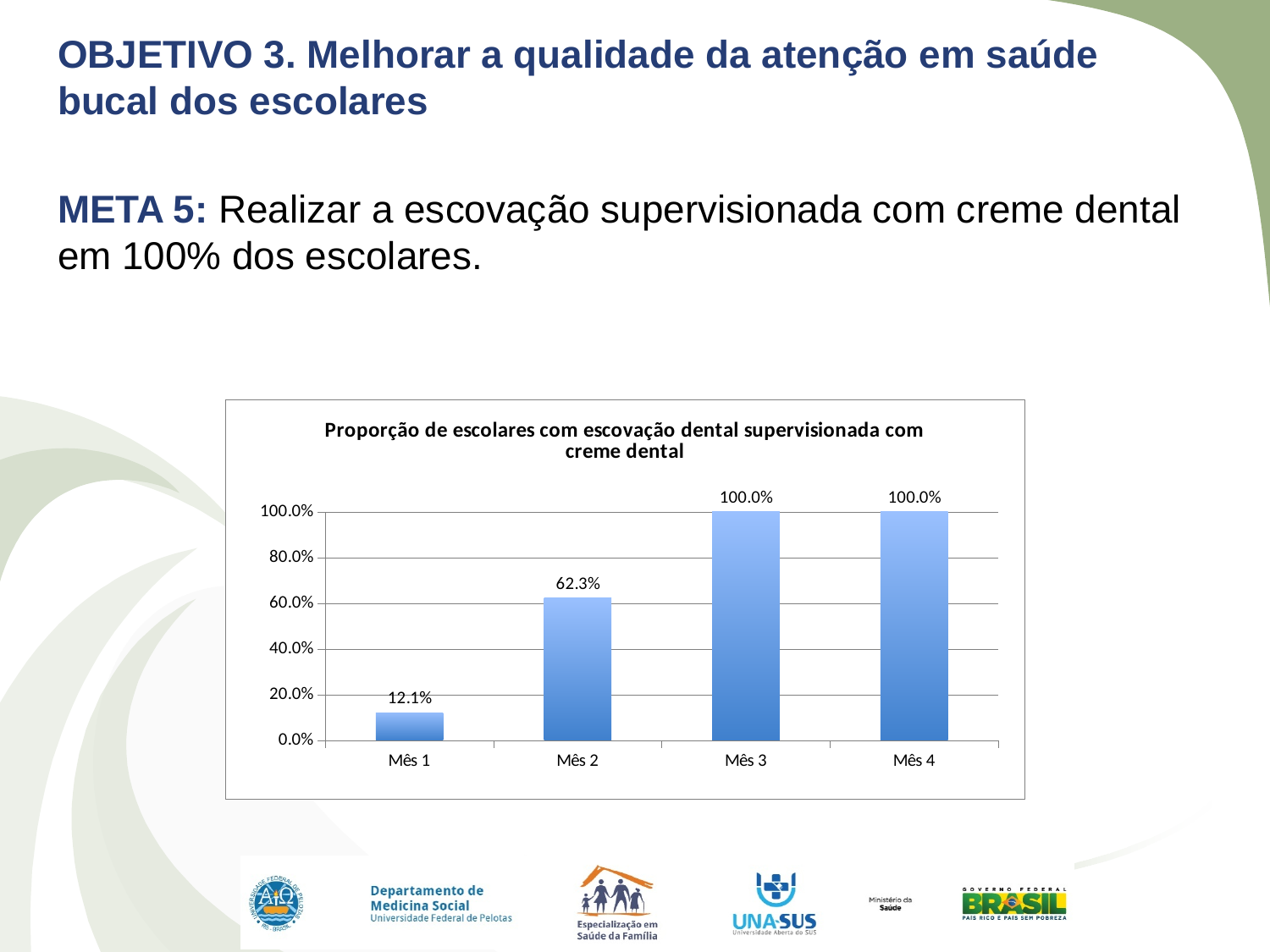
What is the difference between the values for Mês 2 and Mês 1? 50.2% What is the value for Mês 3? 100.0% What kind of chart is shown on the slide? Bar chart What is the difference between the values for Mês 3 and Mês 2? 37.7% What is the value for Mês 1? 12.1% Which is larger, the value for Mês 1 or the value for Mês 2? Mês 2 Which month has the lowest value? Mês 1 How many months are shown on the x axis? 4 Do the values rise or fall from Mês 1 to Mês 3? Rise What is the value for Mês 2? 62.3% Is the value for Mês 2 greater or less than 60.0%? greater What is the title of the chart? Proporção de escolares com escovação dental supervisionada com creme dental